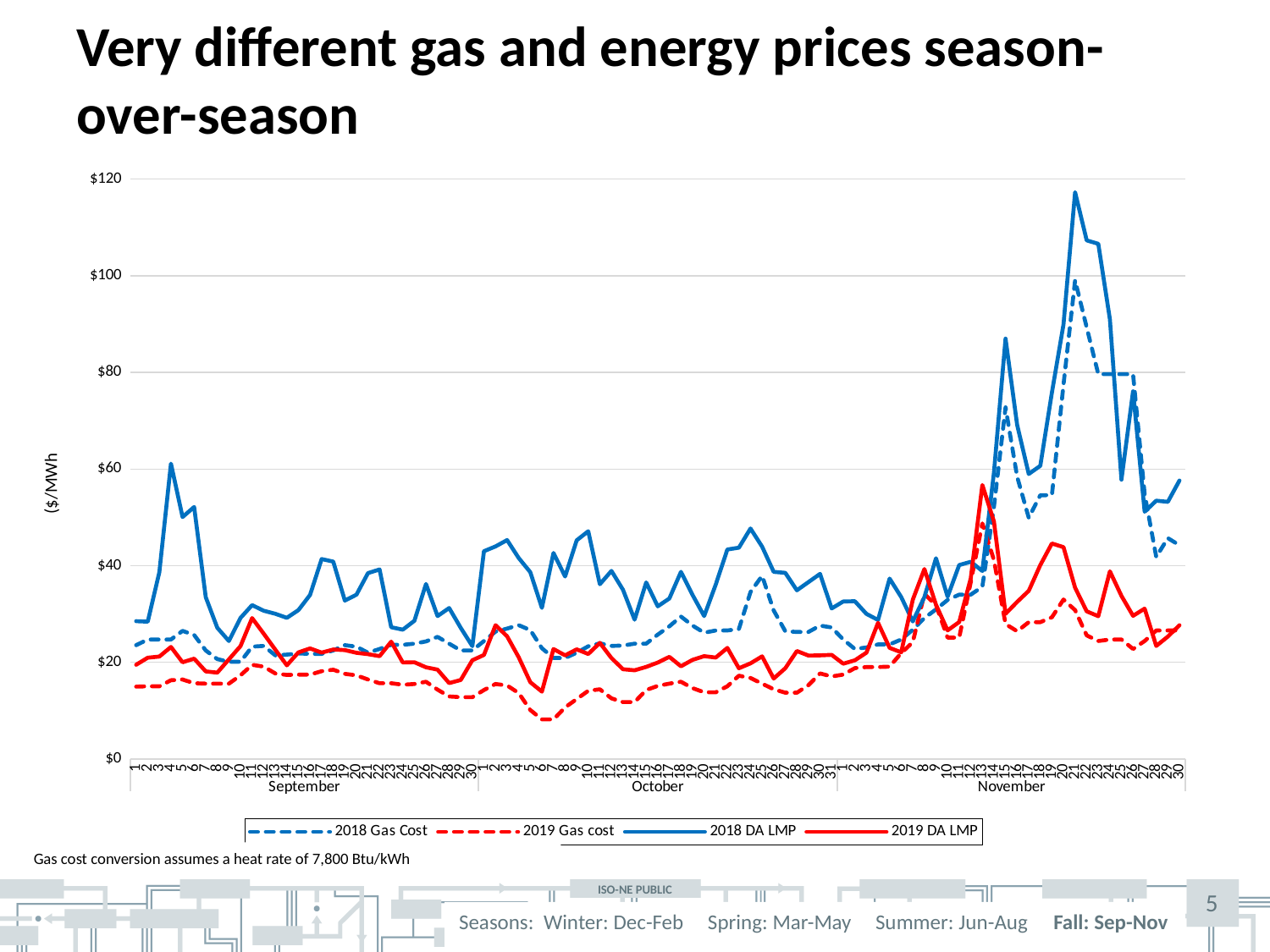
Is the lowest value of the 2019 Gas cost series greater or less than $20? less Does the 2018 DA LMP series rise or fall from November 21 to November 30? fall Is the peak value of the 2019 DA LMP series greater or less than $80? less What unit is shown on the vertical axis label? ($/MWh) How many months are labelled along the x axis? 3 What are the four series listed in the legend? 2018 Gas Cost, 2019 Gas cost, 2018 DA LMP, 2019 DA LMP How many series does the legend list? 4 Is the peak value of the 2018 DA LMP series greater or less than $100? greater What kind of chart is shown on the slide? line chart On September 4, which is higher, 2018 DA LMP or 2019 DA LMP? 2018 DA LMP In which month does the 2018 DA LMP series reach its highest value? November